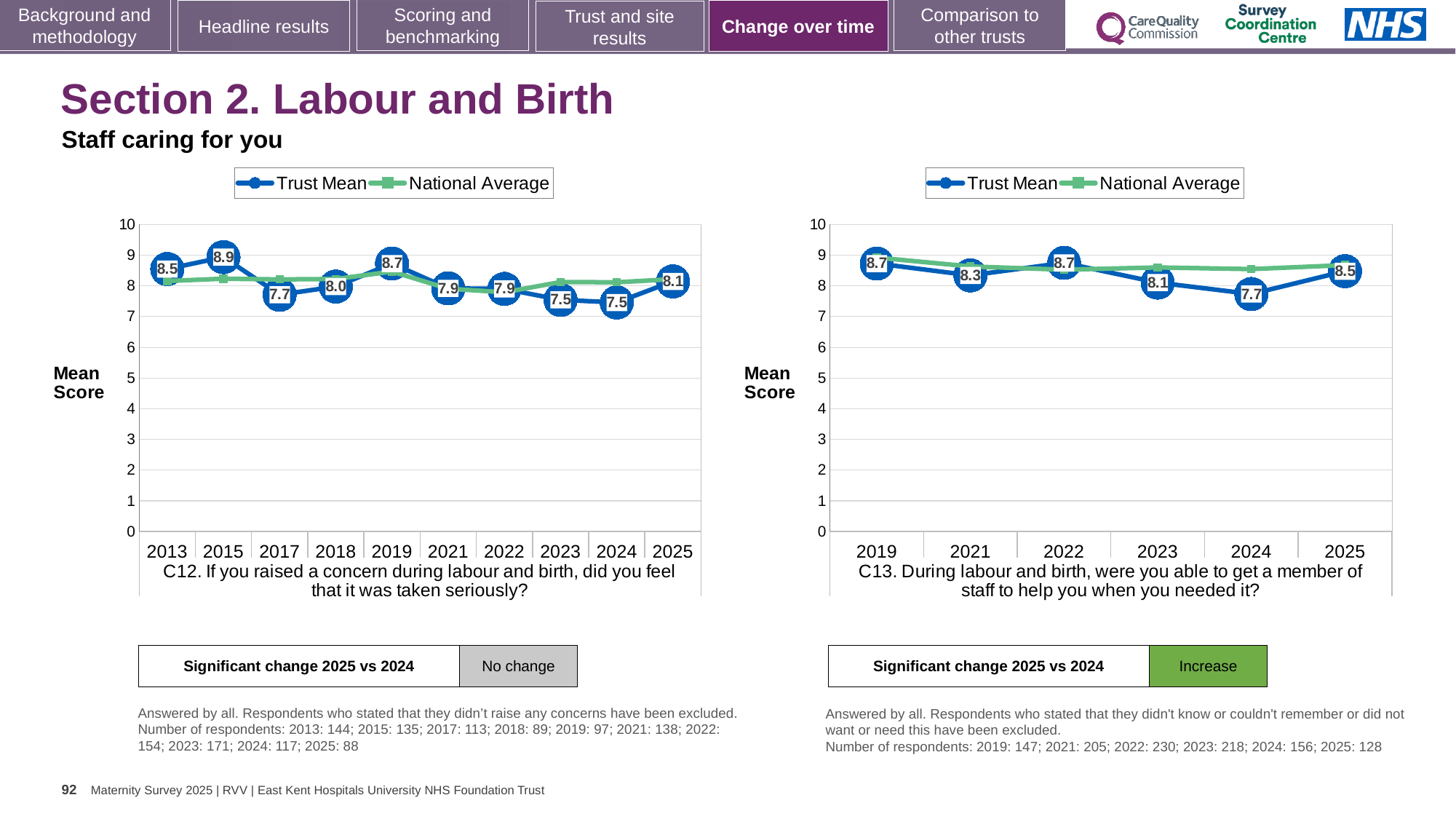
In the C12 chart (left), what is the difference between the Trust Mean in 2015 and in 2024? 1.4 In the C12 chart (left), how many years are plotted on the x axis? 10 In the C13 chart (right), which year has the lowest Trust Mean? 2024 In the C12 chart (left), what is the Trust Mean for 2025? 8.1 In the C12 chart (left), which year has the highest Trust Mean? 2015 What type of chart is the C12 chart (left)? Line chart In the C13 chart (right), what is the Trust Mean for 2021? 8.3 In the C13 chart (right), what is the Trust Mean for 2024? 7.7 In the C13 chart (right), is the Trust Mean higher in 2025 or in 2023? 2025 In the C12 chart (left), what is the Trust Mean for 2015? 8.9 In the C13 chart (right), what is the difference between the Trust Mean in 2025 and in 2024? 0.8 How many series does the legend of the C13 chart (right) list? 2